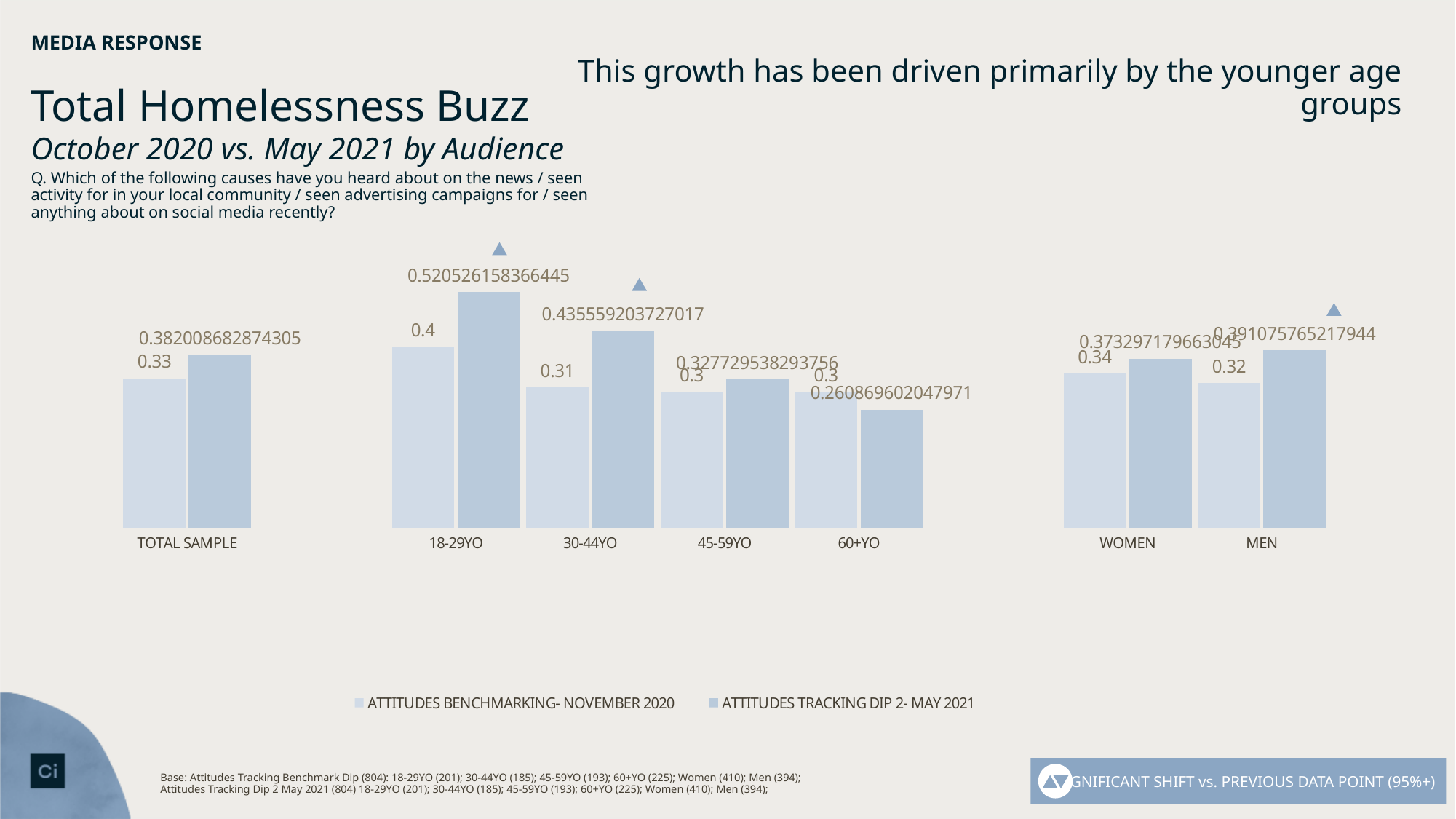
Which category has the lowest value in the ATTITUDES TRACKING DIP 2- MAY 2021 series? 60+YO What is the value for MEN in the ATTITUDES TRACKING DIP 2- MAY 2021 series? 0.391075765217944 For 60+YO, which series has the larger value: ATTITUDES BENCHMARKING- NOVEMBER 2020 or ATTITUDES TRACKING DIP 2- MAY 2021? ATTITUDES BENCHMARKING- NOVEMBER 2020 Which category has the highest value in the ATTITUDES TRACKING DIP 2- MAY 2021 series? 18-29YO What is the value for TOTAL SAMPLE in the ATTITUDES BENCHMARKING- NOVEMBER 2020 series? 0.33 What is the difference between the May 2021 and November 2020 values for 18-29YO? 0.120526158366445 How many categories are shown on the x axis of the chart? 7 Which category has the highest value in the ATTITUDES BENCHMARKING- NOVEMBER 2020 series? 18-29YO What is the value for 60+YO in the ATTITUDES TRACKING DIP 2- MAY 2021 series? 0.260869602047971 What kind of chart is shown on the slide? Bar chart How many series does the chart legend list? 2 What is the value for 18-29YO in the ATTITUDES TRACKING DIP 2- MAY 2021 series? 0.520526158366445